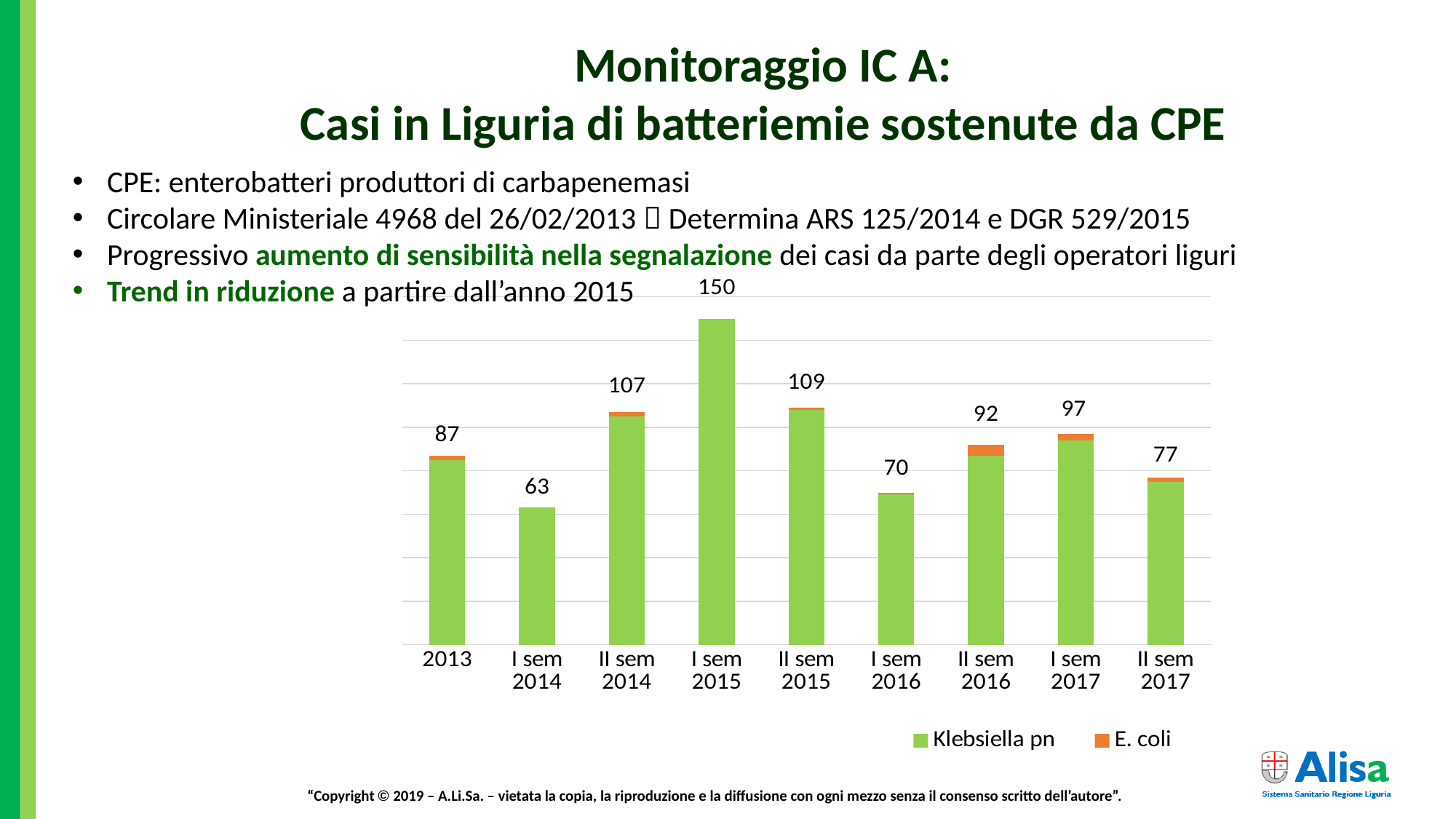
What is the difference between the totals for I sem 2015 and II sem 2015? 41 What is the total number of cases shown for I sem 2014? 63 What kind of chart is shown on the slide? Stacked bar chart What is the difference between the totals for 2013 and I sem 2014? 24 Which series is shown in orange in the legend? E. coli How many periods are shown on the x axis? 9 What is the total number of cases shown for II sem 2017? 77 Which period has the lowest total number of cases? I sem 2014 Which is larger, the total for II sem 2016 or the total for I sem 2017? I sem 2017 How many series does the legend list? 2 What is the total number of cases shown for I sem 2015? 150 Which period has the highest total number of cases? I sem 2015